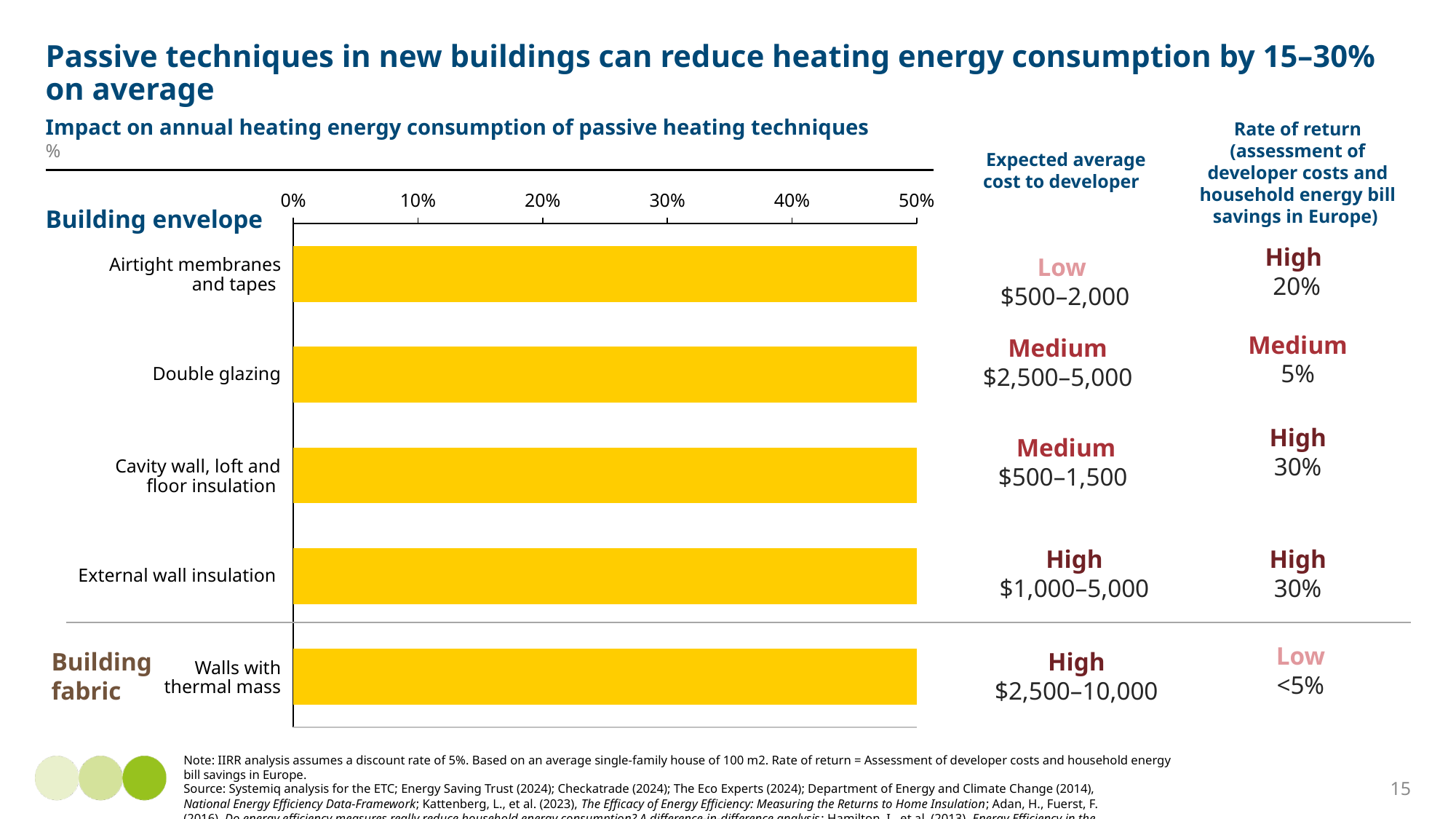
Which technique in the chart belongs to the Building fabric group? Walls with thermal mass What kind of chart is used to show the impact on annual heating energy consumption of passive heating techniques? Bar chart How many techniques are listed under the Building envelope group in the chart? 4 How many passive heating techniques are plotted as bars in the chart? 5 What is the title of the chart? Impact on annual heating energy consumption of passive heating techniques Is the value for Double glazing greater or less than 30%? greater Is the value for Walls with thermal mass greater or less than 20%? greater Is the value for External wall insulation greater or less than 10%? greater